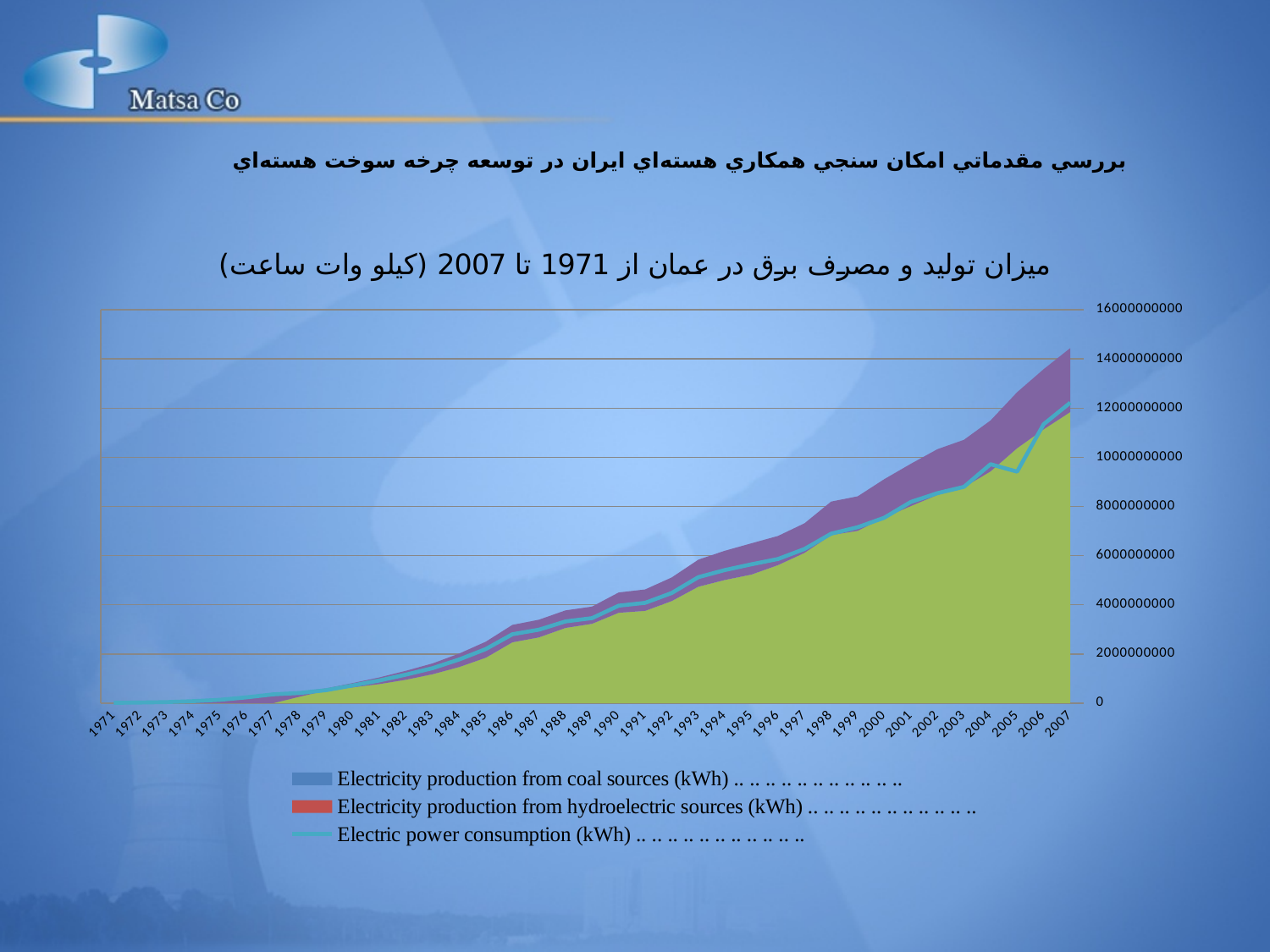
Is the value for Electric power consumption (kWh) in 2000 greater or less than 6000000000? greater How many series does the legend list? 3 What is the first year shown on the x axis? 1971 What is the highest value labelled on the y axis? 16000000000 Is the top of the stacked area in 2007 greater or less than 12000000000? greater Is the top of the stacked area in 1980 greater or less than 2000000000? less How many years are shown along the x axis? 37 What kind of chart is shown on the slide? Combination area and line chart (stacked areas with a line) Do the plotted values generally rise or fall from 1971 to 2007? Rise